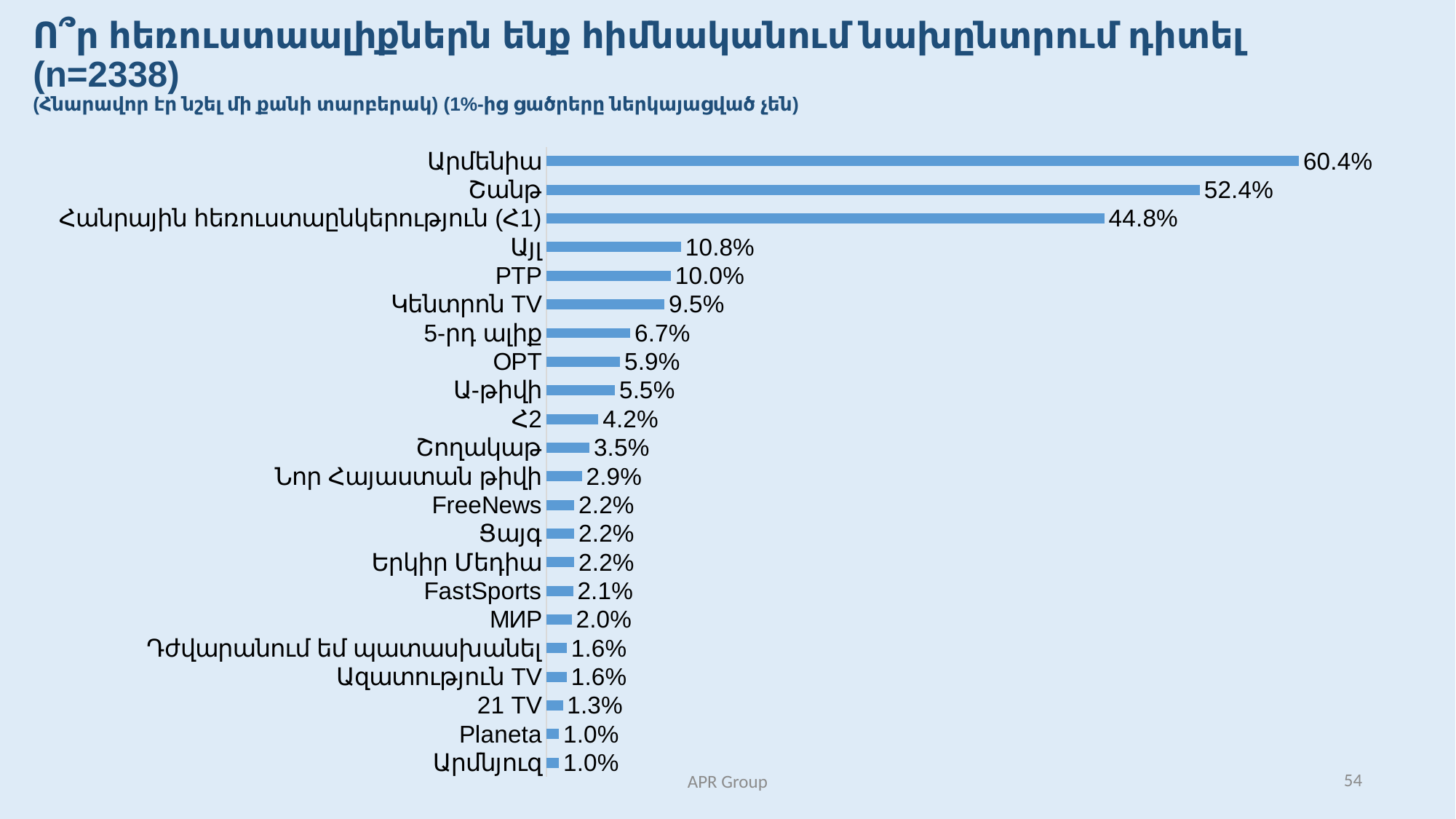
What is the value for Շանթ? 52.4% What is the value for FreeNews? 2.2% What is the sample size (n) stated in the chart title? 2338 What type of chart is shown on the slide? bar chart What is the value for Կենտրոն TV? 9.5% What is the value for Արմենիա? 60.4% How many categories are shown in the chart? 22 What is the difference between the values for Արմենիա and Շանթ? 8.0% Which category has the highest value? Արմենիա What is the value for 21 TV? 1.3% Which is larger, the value for OPT or the value for Ա-թիվի? OPT What is the difference between the values for Այլ and PTP? 0.8%